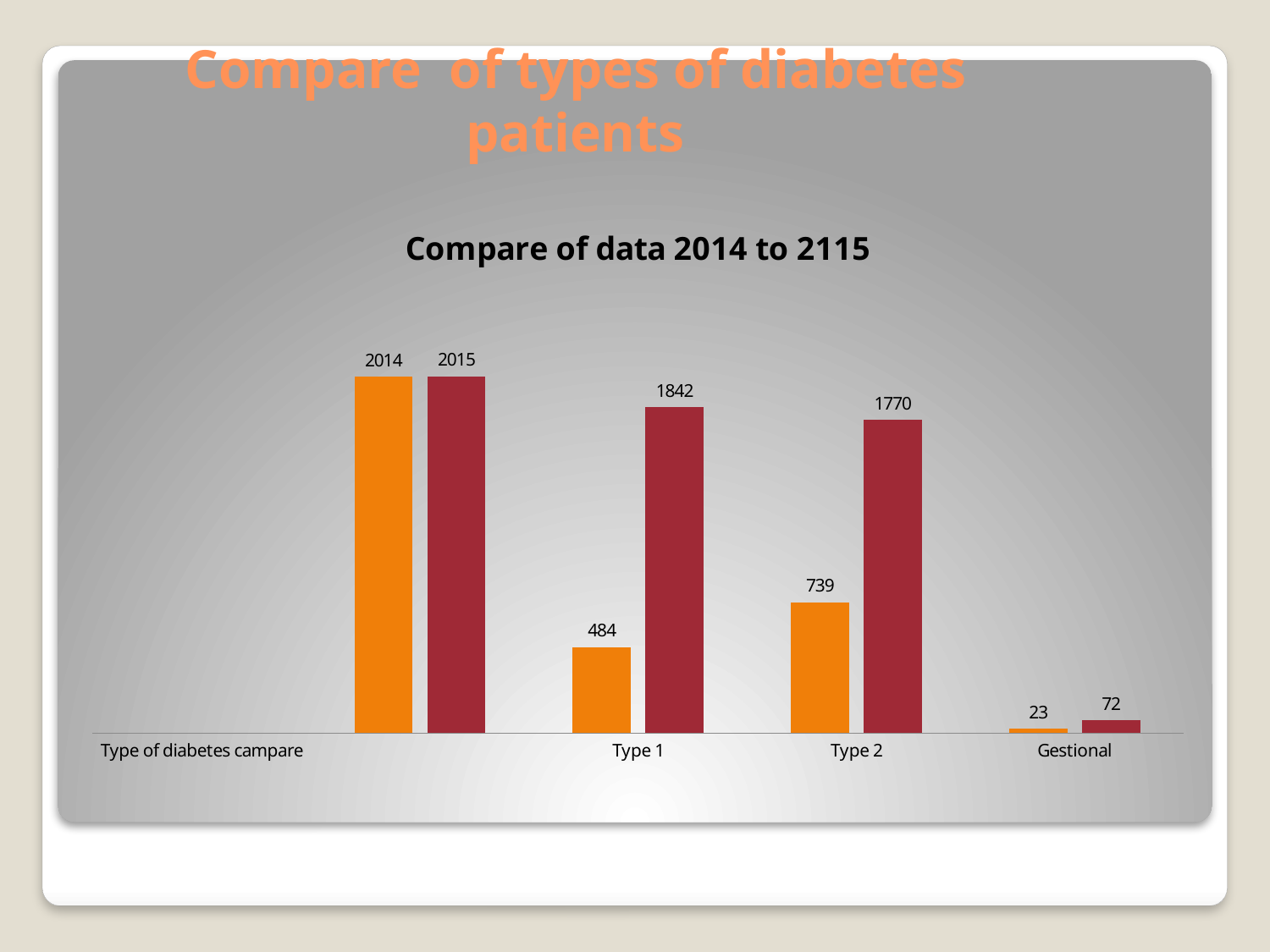
What is the title of the chart? Compare of data 2014 to 2115 What is the difference between the red and orange bars for Gestional? 49 What is the value of the orange bar for Type 1? 484 Which is larger, the red bar for Type 1 or the red bar for Type 2? Type 1 What kind of chart is shown on the slide? bar chart What is the value of the orange bar for Type 2? 739 What is the difference between the red and orange bars for Type 2? 1031 What is the value of the red bar for Gestional? 72 What is the value of the red bar for Type 1? 1842 What is the difference between the red and orange bars for Type 1? 1358 Among Type 1, Type 2 and Gestional, which category has the lowest orange bar? Gestional